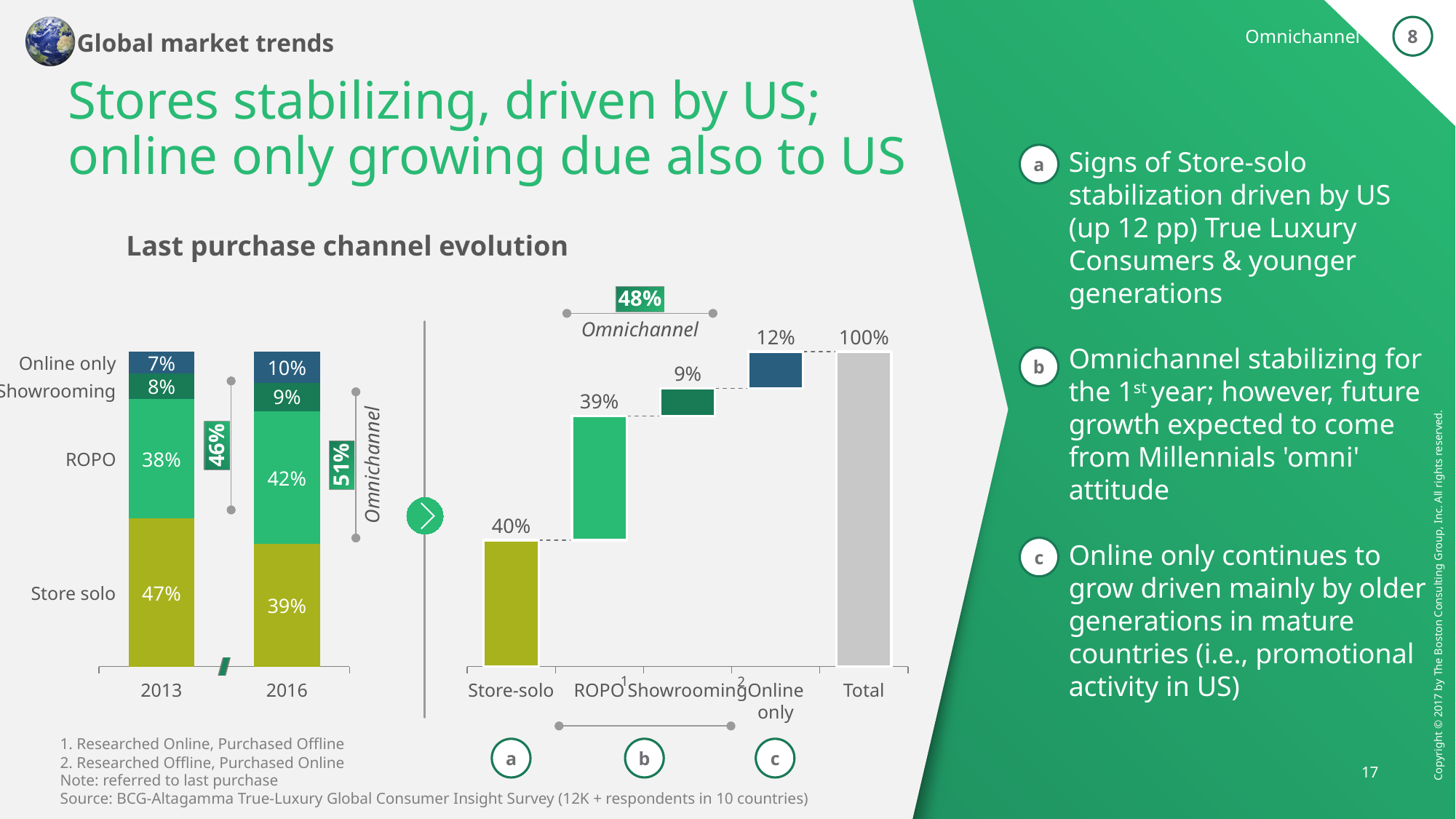
In the right waterfall chart, which channel has the smallest value? Showrooming In the left stacked bar chart, what is the total of the 2016 bar? 100% How many segments (channels) are stacked in each bar of the left chart? 4 In the left stacked bar chart, what is the Store solo share in 2013? 47% In the left stacked bar chart, by how many percentage points did the Store solo share fall from 2013 to 2016? 8 pp What kind of chart is the left chart under 'Last purchase channel evolution'? stacked bar chart In the left stacked bar chart, does the Online only share rise or fall from 2013 to 2016? rise In the left stacked bar chart, what is the ROPO share in 2016? 42% In the right waterfall chart, what is the value for Online only? 12% In the left stacked bar chart, what is the Omnichannel share shown for 2016? 51% In the right waterfall chart, what is the value for Store-solo? 40% How many bars are shown in the right waterfall chart, including Total? 5